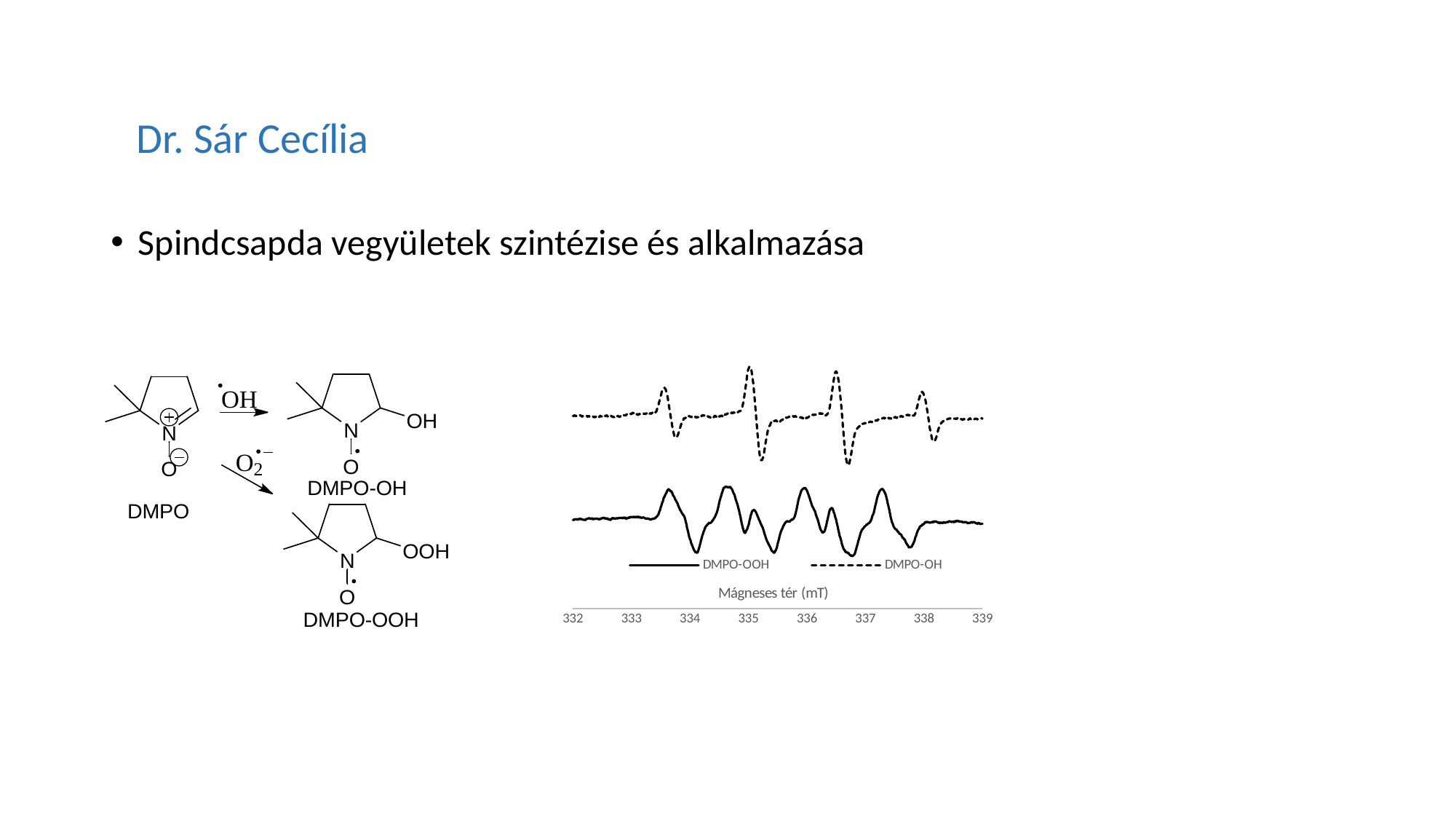
Which series in the chart is drawn with a dashed line? DMPO-OH How many tick labels are shown on the x axis of the chart? 8 What is the lowest value shown on the x axis of the chart? 332 What kind of chart is shown on the right of the slide? line chart What is the highest value shown on the x axis of the chart? 339 What is the title of the x axis of the chart? Mágneses tér (mT) How many series does the legend of the chart list? 2